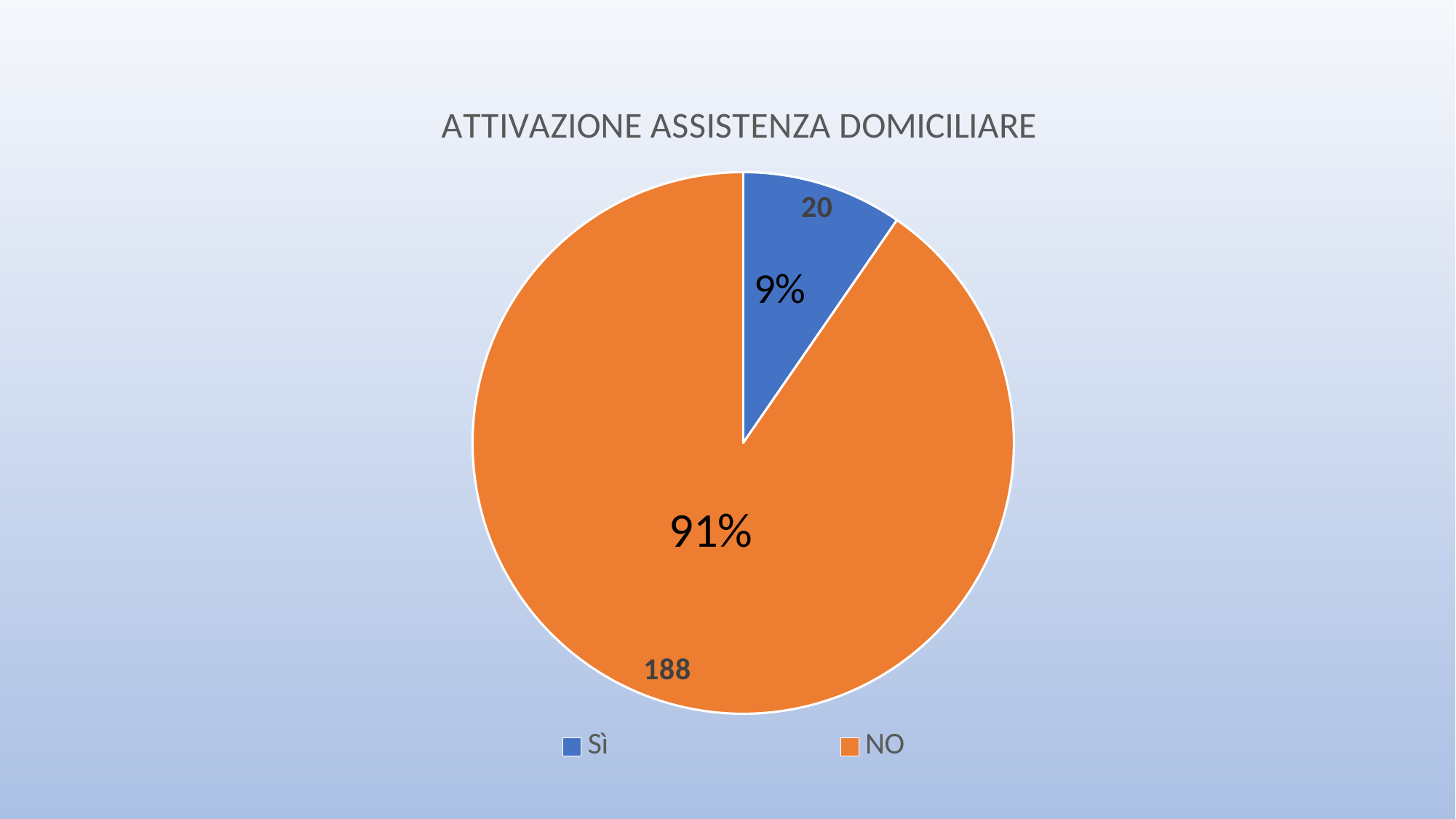
What colour is the NO slice? orange What share of the pie does the Sì slice represent? 9% Which category has the largest slice? NO What share of the pie does the NO slice represent? 91% How many categories does the pie chart have? 2 What is the value for Sì? 20 What kind of chart is shown on the slide? pie chart What is the value for NO? 188 Which category has the smallest slice? Sì Which is larger, the value for Sì or the value for NO? NO What is the difference between the values for NO and Sì? 168 What is the title of the chart? ATTIVAZIONE ASSISTENZA DOMICILIARE